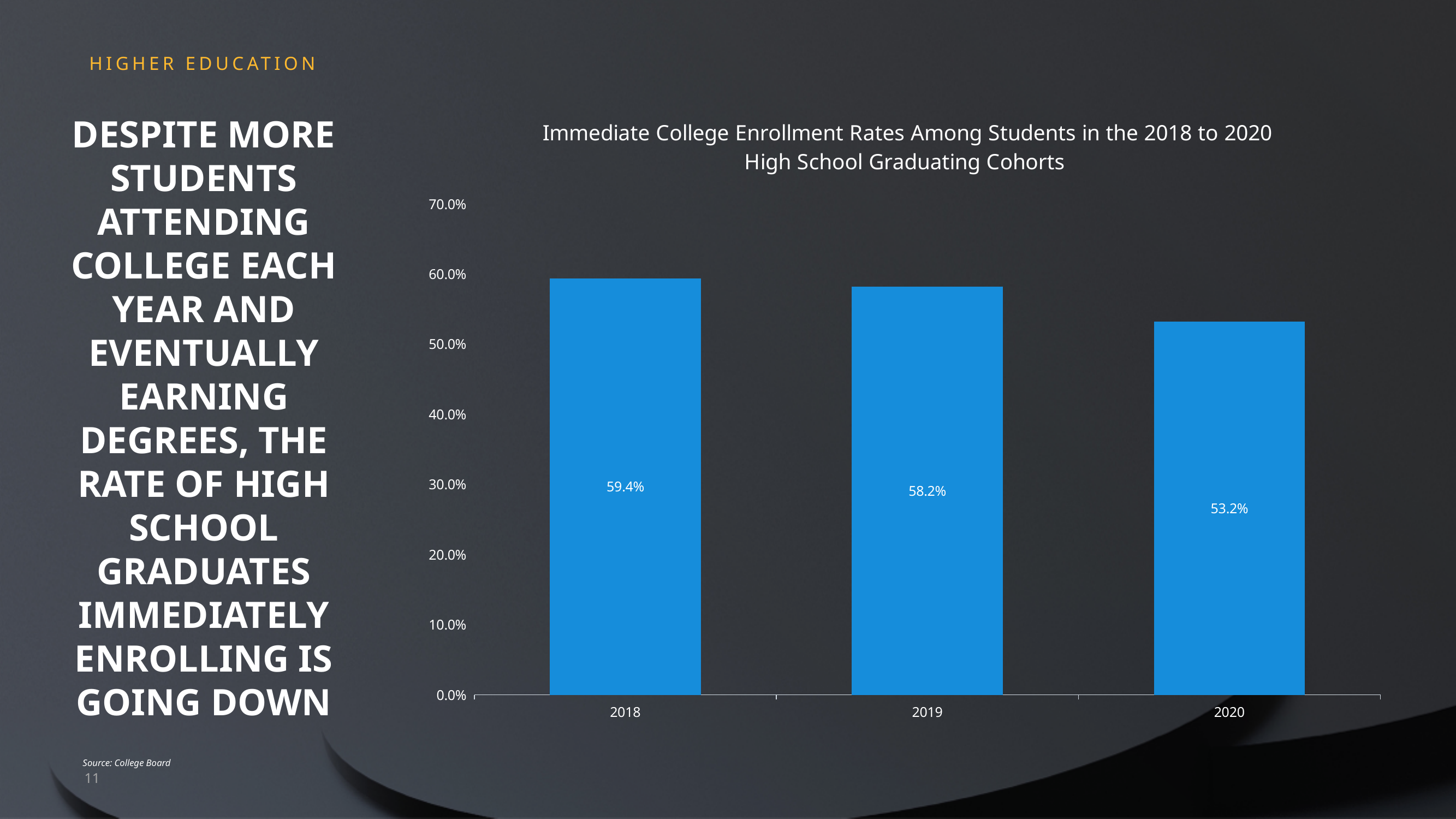
What is the difference between the enrollment rates for 2019 and 2020? 5.0% Do the enrollment rates rise or fall from 2018 to 2020? fall Which year has the highest immediate college enrollment rate? 2018 What kind of chart is shown on the slide? bar chart Which is larger, the enrollment rate for 2019 or for 2020? 2019 How many graduating cohorts are shown in the chart? 3 What is the immediate college enrollment rate for the 2019 cohort? 58.2% What is the difference between the enrollment rates for 2018 and 2020? 6.2% What is the immediate college enrollment rate for the 2018 cohort? 59.4% Is the value for 2020 greater or less than 60.0%? less Which year has the lowest immediate college enrollment rate? 2020 What is the immediate college enrollment rate for the 2020 cohort? 53.2%